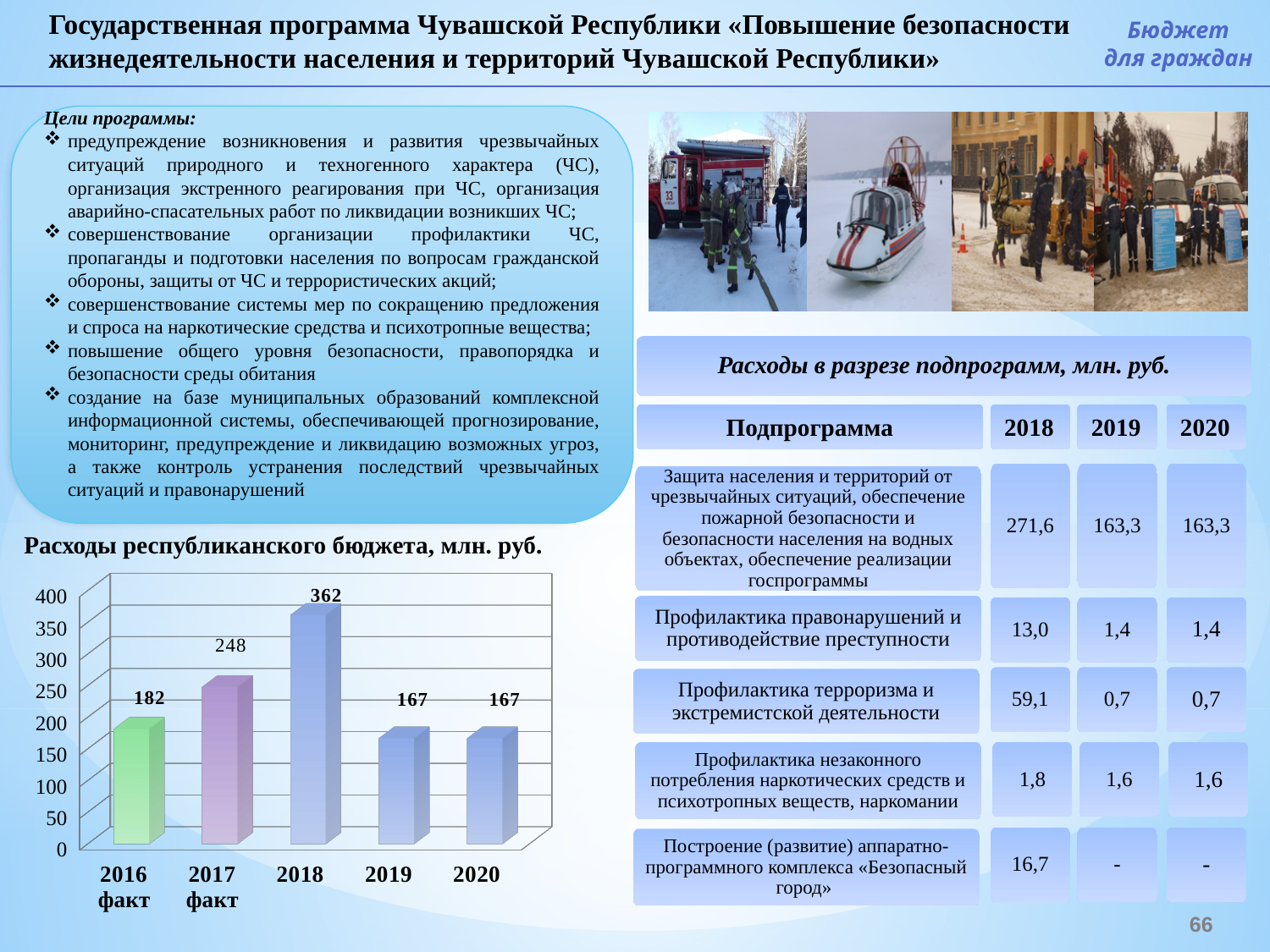
What kind of chart is 'Расходы республиканского бюджета, млн. руб.'? bar chart What is the value for 2018 in the chart 'Расходы республиканского бюджета, млн. руб.'? 362 What is the difference between the values for 2017 факт and 2016 факт in the chart 'Расходы республиканского бюджета, млн. руб.'? 66 Which year has the highest value in the chart 'Расходы республиканского бюджета, млн. руб.'? 2018 How many bars are shown in the chart 'Расходы республиканского бюджета, млн. руб.'? 5 What is the value for 2017 факт in the chart 'Расходы республиканского бюджета, млн. руб.'? 248 What is the difference between the values for 2018 and 2017 факт in the chart 'Расходы республиканского бюджета, млн. руб.'? 114 Is the value for 2018 in the chart 'Расходы республиканского бюджета, млн. руб.' greater or less than 350? greater What is the value for 2020 in the chart 'Расходы республиканского бюджета, млн. руб.'? 167 In the chart 'Расходы республиканского бюджета, млн. руб.', does the value rise or fall from 2018 to 2019? fall What is the value for 2016 факт in the chart 'Расходы республиканского бюджета, млн. руб.'? 182 In the chart 'Расходы республиканского бюджета, млн. руб.', which is larger: the value for 2016 факт or the value for 2019? 2016 факт